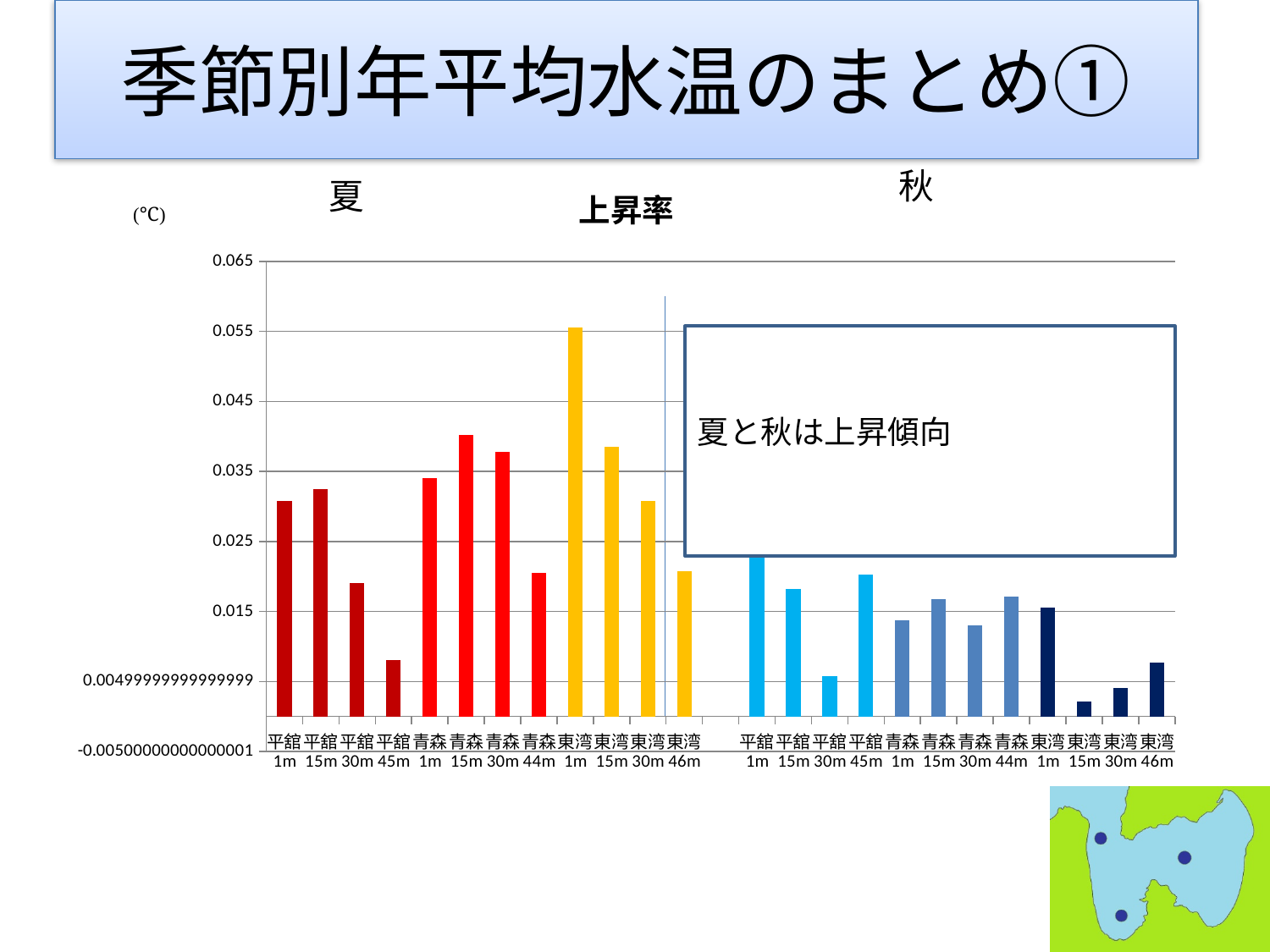
Which is larger, the value for 夏 平舘 15m or 夏 平舘 30m? 夏 平舘 15m How many bars are plotted in total across both the 夏 and 秋 groups? 24 Is the value for 夏 平舘 45m greater or less than 0.015? less Within the 夏 (summer) group, which bar is the lowest? 平舘 45m What kind of chart is shown on the slide? bar chart What is the title of the chart? 上昇率 What unit is shown on the chart's vertical axis? ℃ Is the value for 夏 東湾 1m greater or less than 0.045? greater Which bar is the highest in the whole chart? 夏 東湾 1m How many bars are plotted in the 夏 (summer) group? 12 Is the value for 秋 平舘 30m greater or less than 0.015? less Which is larger, the value for 秋 平舘 1m or 秋 平舘 15m? 秋 平舘 1m